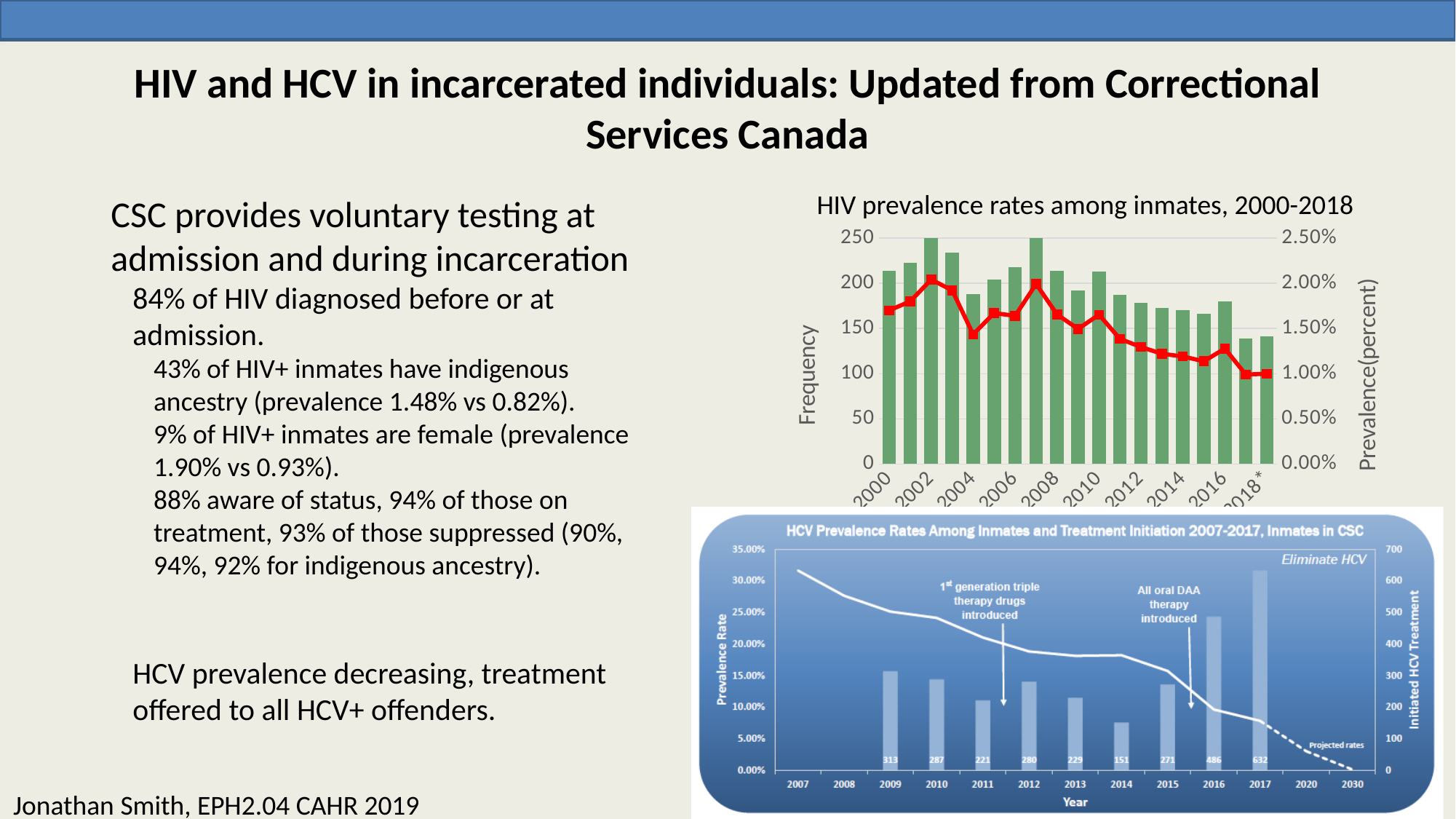
In the chart titled 'HIV prevalence rates among inmates, 2000-2018', is the frequency for 2008 greater or less than 200? greater In the chart titled 'HCV Prevalence Rates Among Inmates and Treatment Initiation 2007-2017, Inmates in CSC', what is the difference in initiated HCV treatments between 2017 and 2016? 146 In the chart titled 'HCV Prevalence Rates Among Inmates and Treatment Initiation 2007-2017, Inmates in CSC', how many inmates initiated HCV treatment in 2017? 632 In the chart titled 'HIV prevalence rates among inmates, 2000-2018', which year has the highest prevalence on the red line? 2002 In the chart titled 'HCV Prevalence Rates Among Inmates and Treatment Initiation 2007-2017, Inmates in CSC', which year has the highest number of initiated HCV treatments? 2017 In the chart titled 'HIV prevalence rates among inmates, 2000-2018', does the prevalence line generally rise or fall from 2000 to 2018? Fall In the chart titled 'HIV prevalence rates among inmates, 2000-2018', what is the label of the left vertical axis? Frequency In the chart titled 'HCV Prevalence Rates Among Inmates and Treatment Initiation 2007-2017, Inmates in CSC', how many inmates initiated HCV treatment in 2014? 151 In the chart titled 'HIV prevalence rates among inmates, 2000-2018', what kind of chart is used? A bar chart combined with a line chart In the chart titled 'HCV Prevalence Rates Among Inmates and Treatment Initiation 2007-2017, Inmates in CSC', does the prevalence rate line rise or fall from 2007 to 2017? Fall In the chart titled 'HIV prevalence rates among inmates, 2000-2018', is the prevalence for 2018* greater or less than 1.50%? less In the chart titled 'HCV Prevalence Rates Among Inmates and Treatment Initiation 2007-2017, Inmates in CSC', which year has the lowest number of initiated HCV treatments? 2014